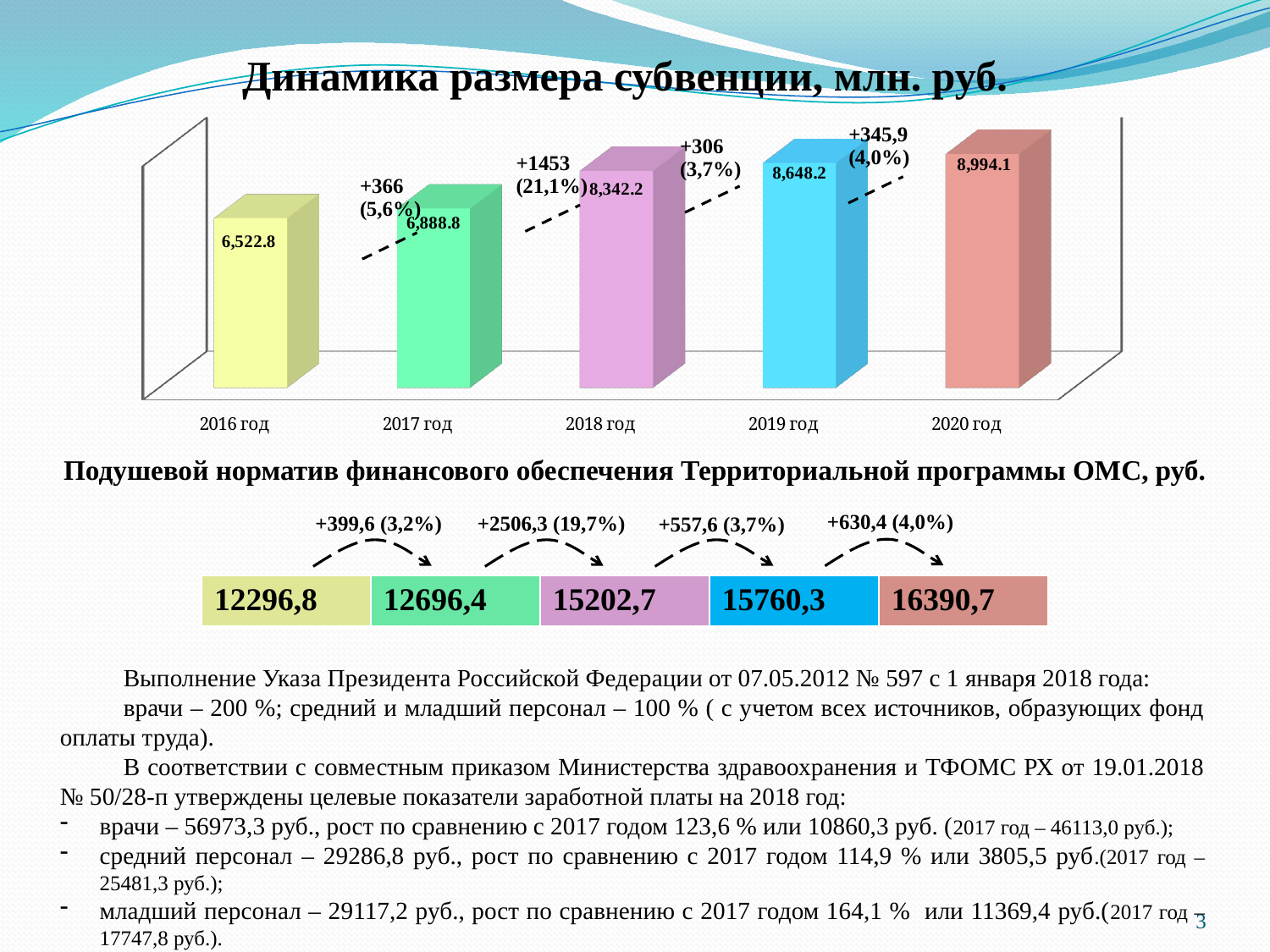
Which year has the highest value in the bar chart? 2020 год What is the difference between the values for 2019 год and 2018 год in the bar chart? 306 What is the value for 2016 год in the bar chart? 6,522.8 What is the difference between the values for 2020 год and 2016 год in the bar chart? 2,471.3 Do the values in the bar chart rise or fall from 2016 год to 2020 год? rise What is the title of the bar chart at the top of the slide? Динамика размера субвенции, млн. руб. How many bars (years) are shown in the bar chart? 5 What is the value for 2020 год in the bar chart? 8,994.1 Which is larger in the bar chart, the value for 2017 год or the value for 2019 год? 2019 год What kind of chart is shown under the title "Динамика размера субвенции, млн. руб."? bar chart Which year has the lowest value in the bar chart? 2016 год What is the value for 2018 год in the bar chart? 8,342.2